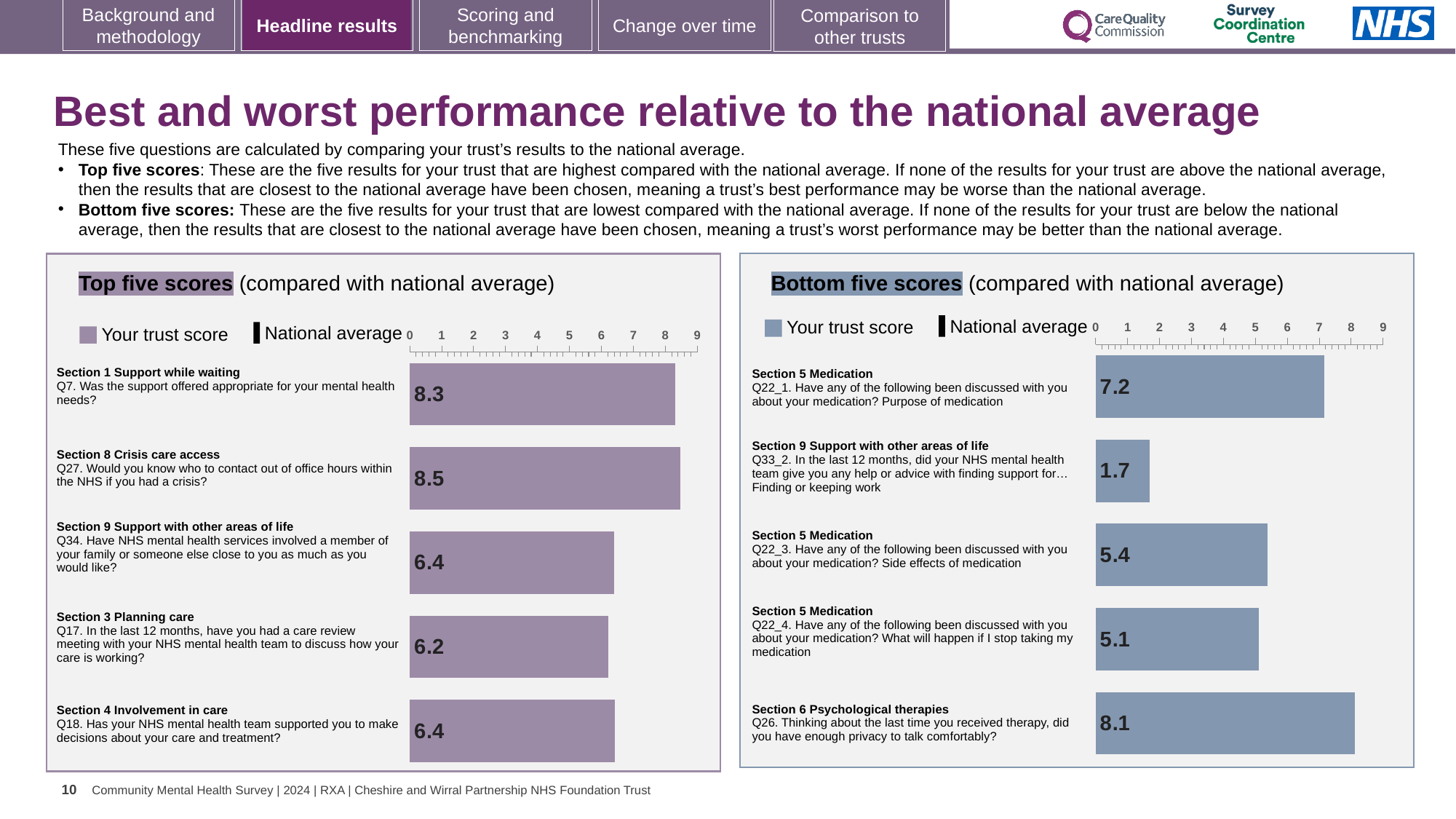
In the Bottom five scores chart, what is the difference between the trust scores for Q26 and Q33_2? 6.4 In the Top five scores chart, what is the trust score for Q7 (Was the support offered appropriate for your mental health needs?)? 8.3 In the Bottom five scores chart, which has the larger trust score: Q22_1 (Purpose of medication) or Q26 (enough privacy to talk comfortably)? Q26 In the Top five scores chart, what is the trust score for Q27 (Would you know who to contact out of office hours within the NHS if you had a crisis?)? 8.5 In the Bottom five scores chart, which question has the lowest trust score? Q33_2 (Section 9 Support with other areas of life) In the Bottom five scores chart, which question has the highest trust score? Q26 (Section 6 Psychological therapies) What two entries does the legend of the Top five scores chart list? Your trust score and National average What type of chart is the Bottom five scores chart? Bar chart In the Top five scores chart, what is the difference between the trust scores for Q27 and Q17? 2.3 In the Top five scores chart, which question has the highest trust score? Q27 (Section 8 Crisis care access) In the Bottom five scores chart, what is the trust score for Q33_2 (help or advice with finding or keeping work)? 1.7 How many bars are plotted in the Top five scores chart? 5